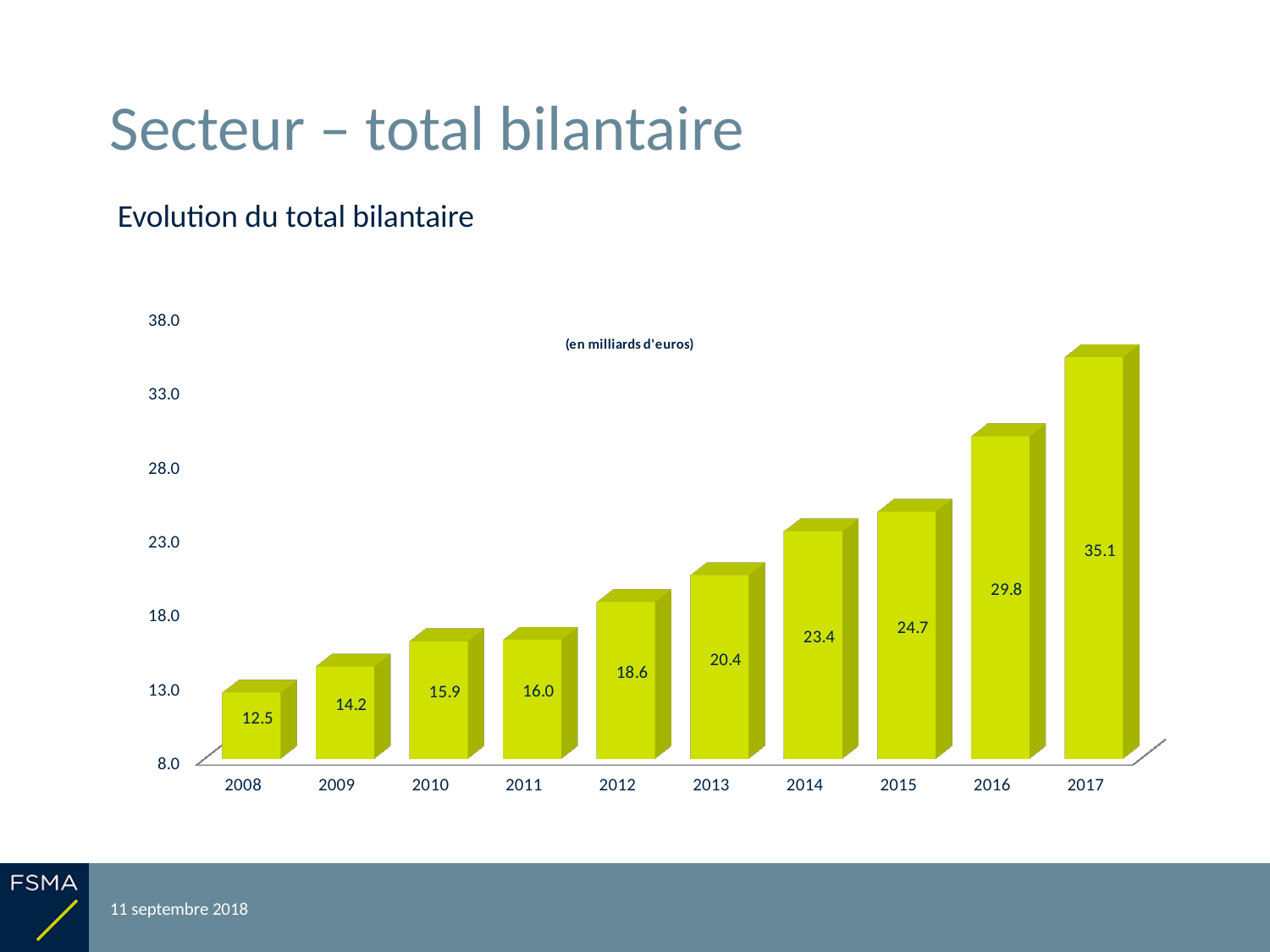
What kind of chart is shown? bar chart Is the value for 2016 greater or less than 28.0? greater What is the difference between the values for 2017 and 2008? 22.6 Which year has the lowest value? 2008 What is the value for 2016? 29.8 Which is larger, the value for 2013 or the value for 2011? 2013 How many years are shown on the x axis? 10 What is the difference between the values for 2015 and 2014? 1.3 What is the value for 2012? 18.6 Which year has the highest value? 2017 What is the value for 2008? 12.5 Do the values rise or fall from 2008 to 2017? rise